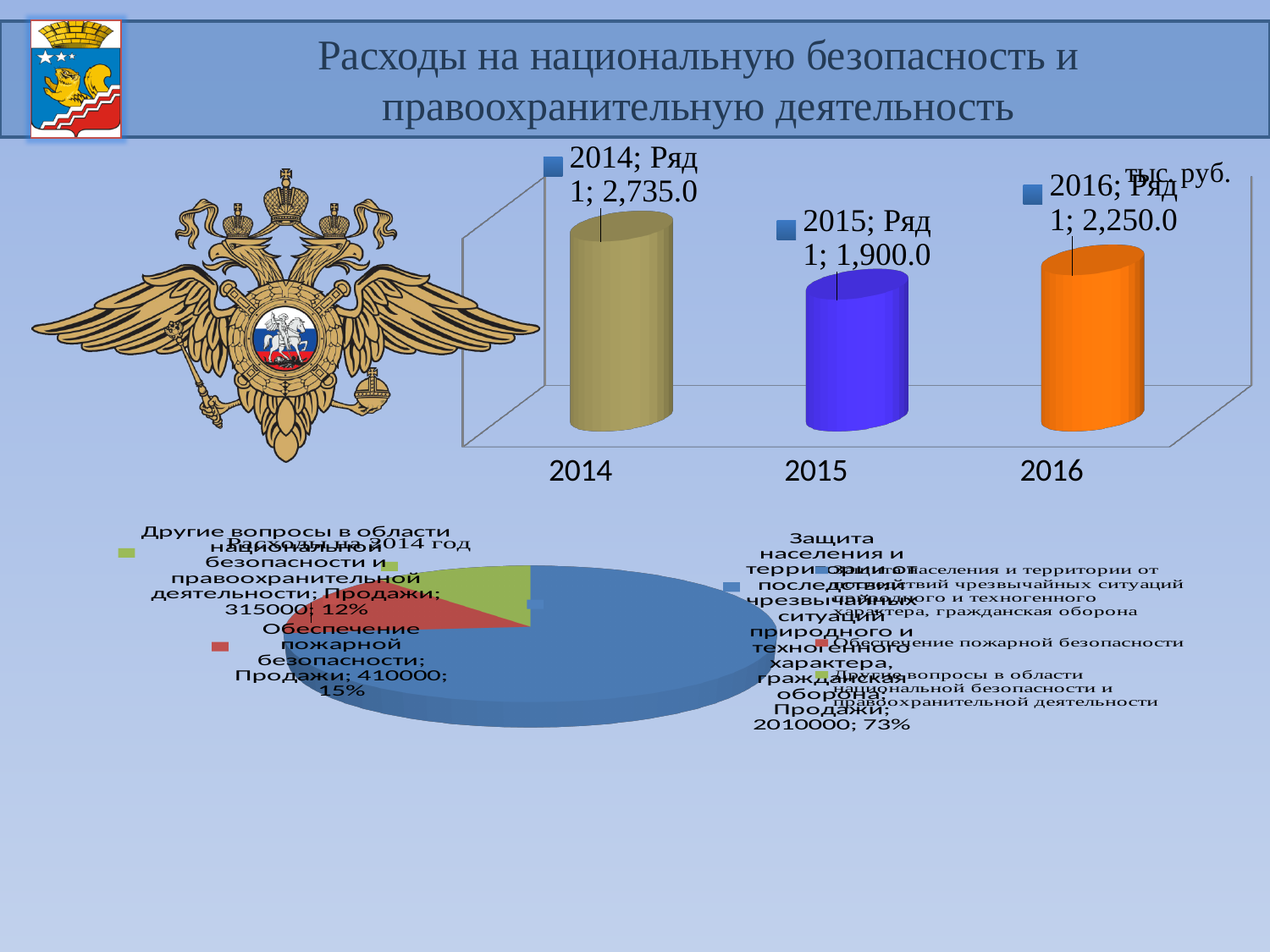
What type of chart is the chart at the top of the slide? bar chart In the bar chart at the top of the slide, which year has the highest value? 2014 In the bar chart at the top of the slide, which is larger, the value for 2016 or the value for 2015? 2016 In the pie chart "Расходы на 2014 год", what is the value for "Другие вопросы в области национальной безопасности и правоохранительной деятельности"? 315000 In the bar chart at the top of the slide, which year has the lowest value? 2015 In the bar chart at the top of the slide, what is the value for 2015? 1,900.0 In the bar chart at the top of the slide, how many years are shown? 3 In the bar chart at the top of the slide, what is the value for 2016? 2,250.0 In the bar chart at the top of the slide, what is the value for 2014? 2,735.0 In the pie chart "Расходы на 2014 год", how many slices are there? 3 In the bar chart at the top of the slide, what is the difference between the values for 2014 and 2015? 835.0 In the pie chart "Расходы на 2014 год", what share does "Обеспечение пожарной безопасности" have? 15%